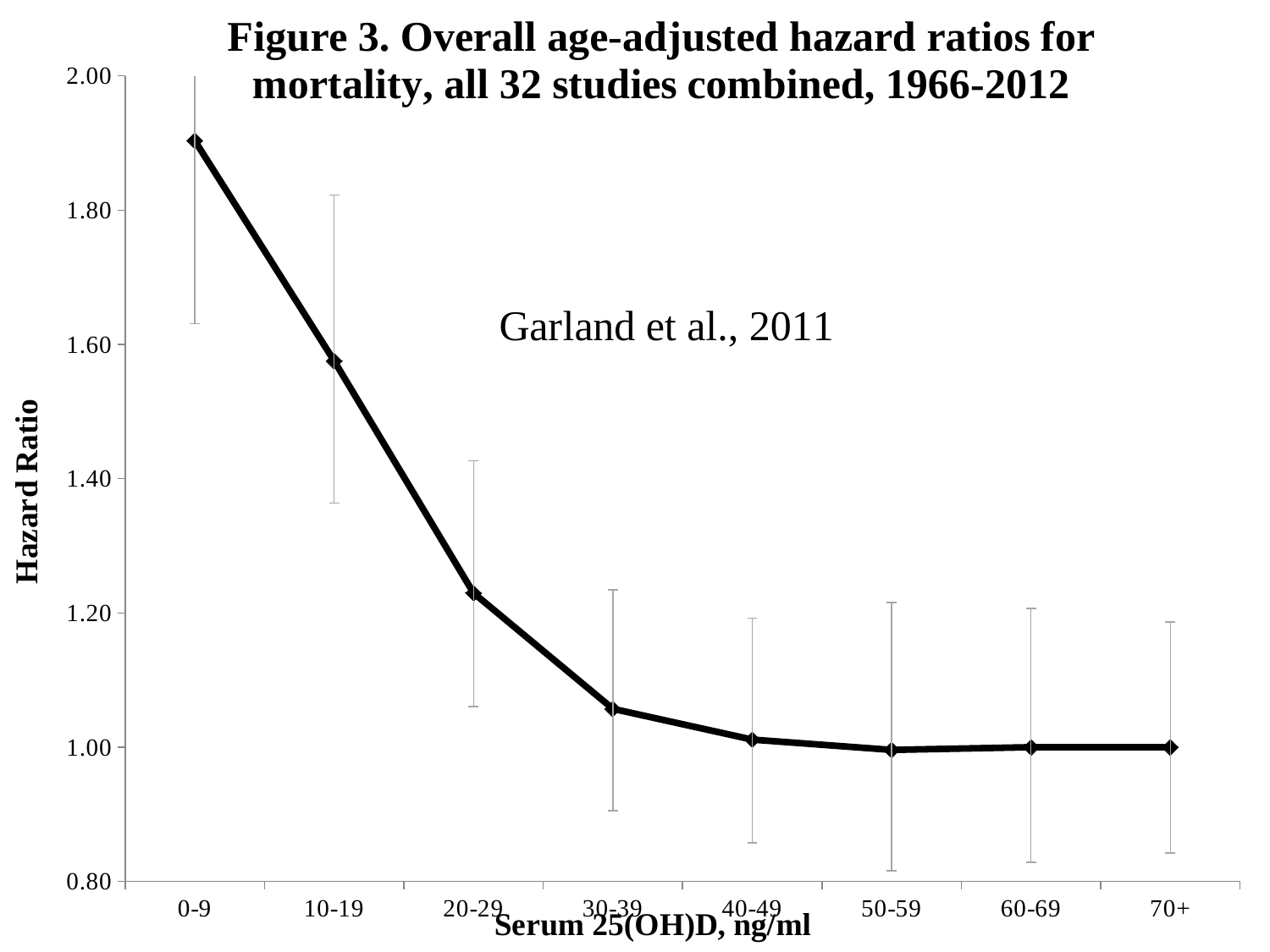
Which serum 25(OH)D category has the highest hazard ratio? 0-9 Do the hazard ratios rise or fall as serum 25(OH)D increases along the x axis? fall Is the hazard ratio for the 0-9 category greater or less than 1.80? greater What is the label of the y axis? Hazard Ratio What is the label of the x axis? Serum 25(OH)D, ng/ml Which has the larger hazard ratio, the 20-29 category or the 30-39 category? 20-29 Is the hazard ratio for the 30-39 category greater or less than 1.20? less Is the hazard ratio for the 20-29 category greater or less than 1.20? greater What kind of chart is shown on the slide? line chart Which has the larger hazard ratio, the 0-9 category or the 10-19 category? 0-9 How many serum 25(OH)D categories are plotted along the x axis? 8